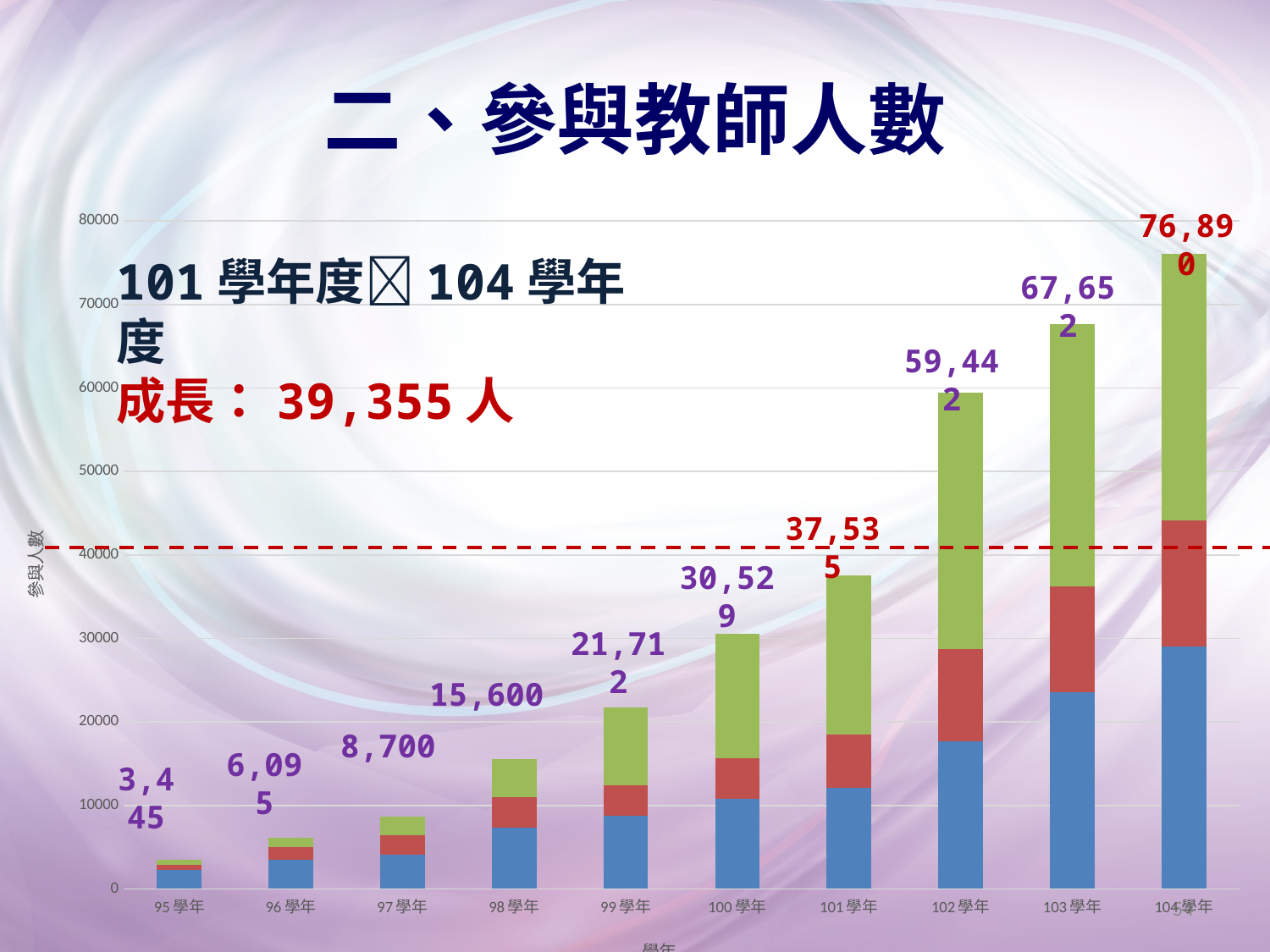
Which is larger, the total for 102 學年 or the total for 100 學年? 102 學年 Which school year has the highest total number of participating teachers? 104 學年 What is the total labelled for 101 學年? 37,535 What is the total labelled for 104 學年? 76,890 What is the total labelled for 95 學年? 3,445 What is the total labelled for 98 學年? 15,600 Do the totals rise or fall from 95 學年 to 104 學年? Rise What is the difference between the totals for 104 學年 and 101 學年? 39,355 Which school year has the lowest total number of participating teachers? 95 學年 What kind of chart is shown on the slide? Stacked bar chart Is the total for 103 學年 greater or less than 60000? greater How many school years are shown on the x axis? 10